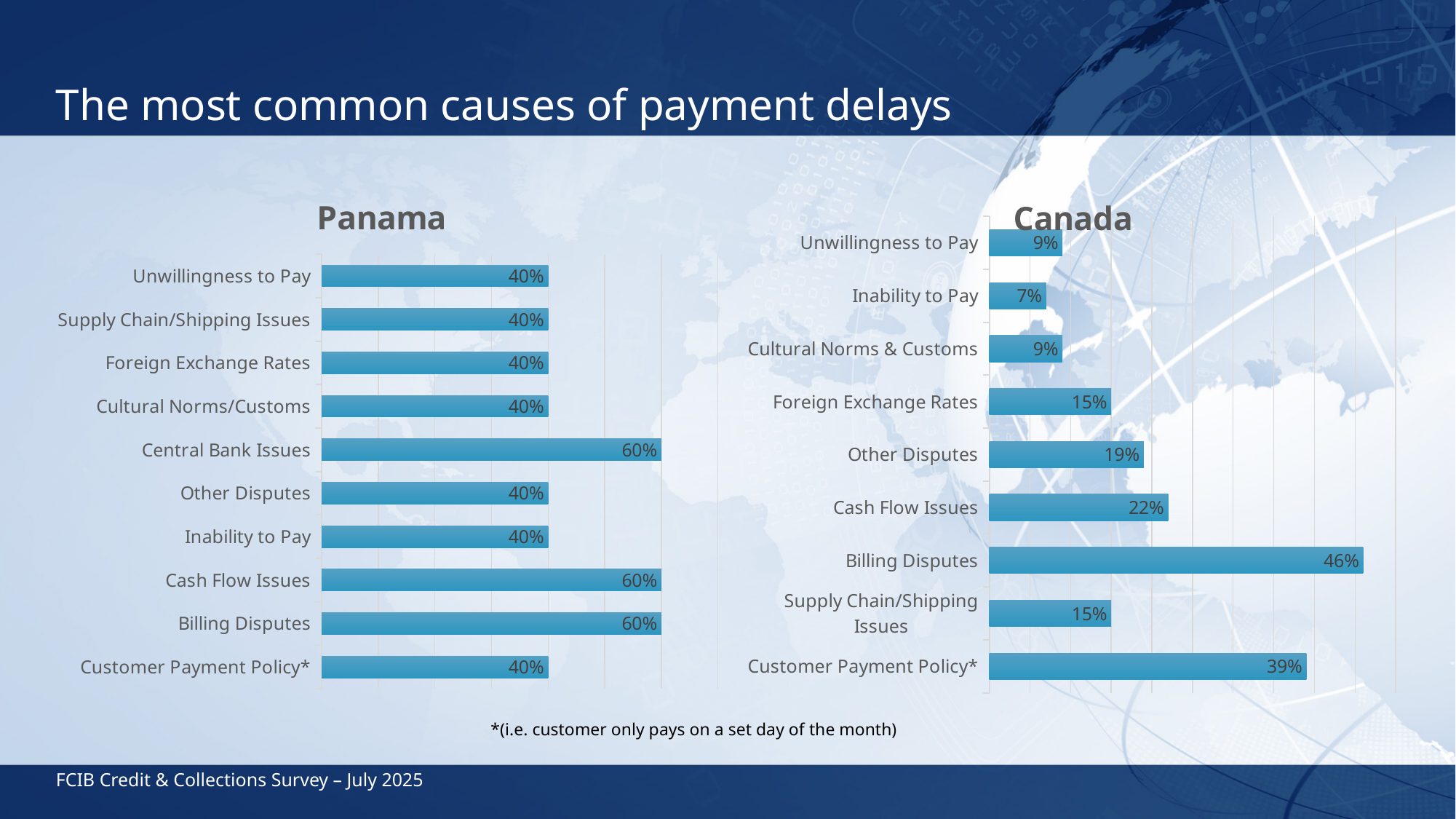
In the Canada chart, what is the difference between Billing Disputes and Customer Payment Policy*? 7% In the Canada chart, which category has the lowest value? Inability to Pay How many categories are shown in the Canada chart? 9 In the Canada chart, what is the value for Billing Disputes? 46% In the Panama chart, what is the value for Central Bank Issues? 60% In the Canada chart, what is the value for Cash Flow Issues? 22% In the Canada chart, which is larger, Other Disputes or Foreign Exchange Rates? Other Disputes In the Canada chart, which category has the highest value? Billing Disputes In the Panama chart, what is the difference between Cash Flow Issues and Other Disputes? 20% In the Panama chart, what is the value for Customer Payment Policy*? 40% How many categories are shown in the Panama chart? 10 What type of chart is the Canada chart? Bar chart